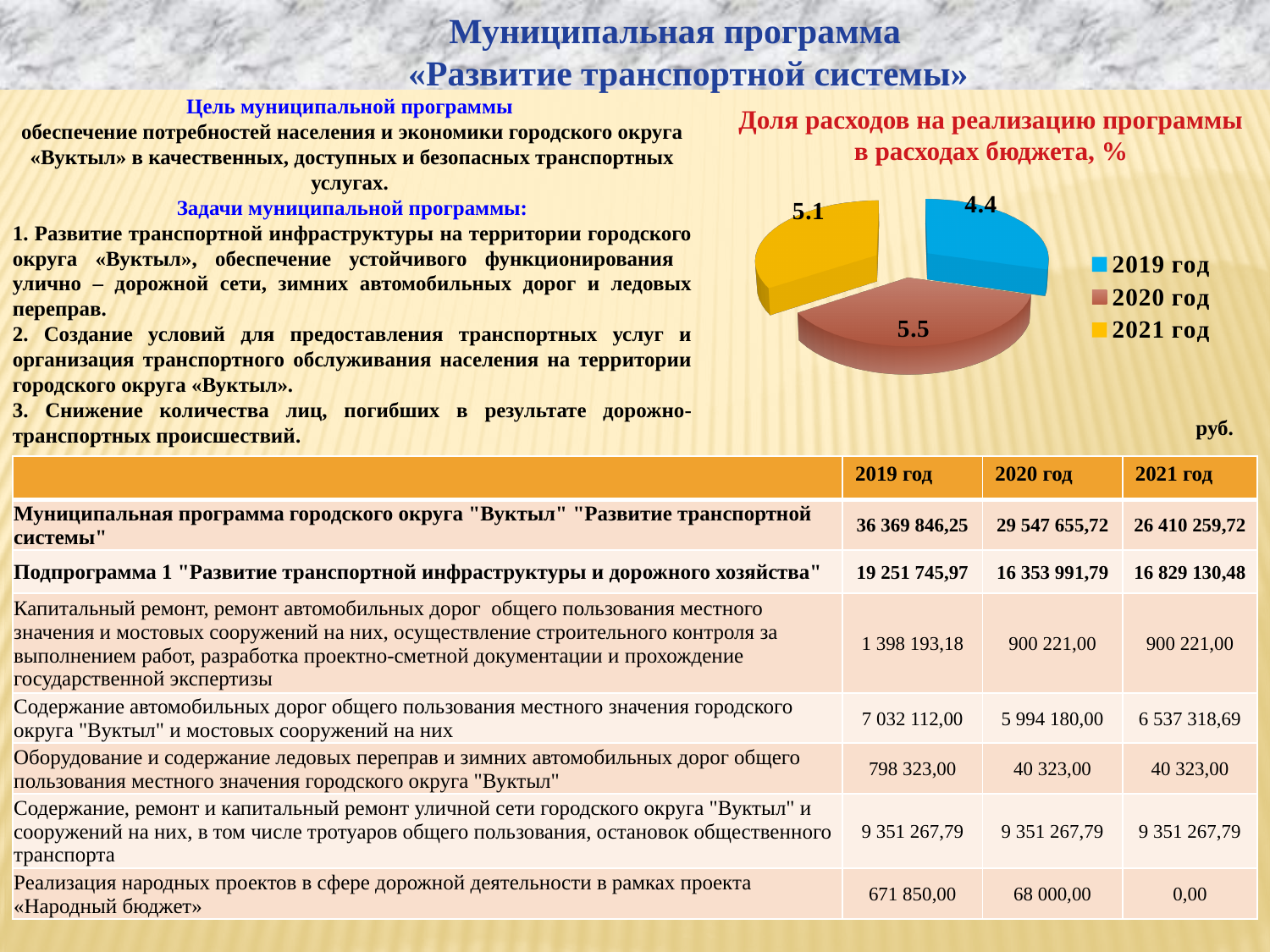
Which year has the smallest slice in the pie chart? 2019 год What is the title of the pie chart? Доля расходов на реализацию программы в расходах бюджета, % What is the difference between the values for 2020 год and 2019 год in the pie chart? 1.1 Which is larger in the pie chart, the value for 2021 год or the value for 2019 год? 2021 год How many entries does the legend of the pie chart list? 3 What is the value for 2020 год in the pie chart? 5.5 What is the value for 2019 год in the pie chart? 4.4 Which year has the largest slice in the pie chart? 2020 год What kind of chart is shown on the slide? pie chart How many slices does the pie chart have? 3 What is the difference between the values for 2021 год and 2019 год in the pie chart? 0.7 What is the value for 2021 год in the pie chart? 5.1